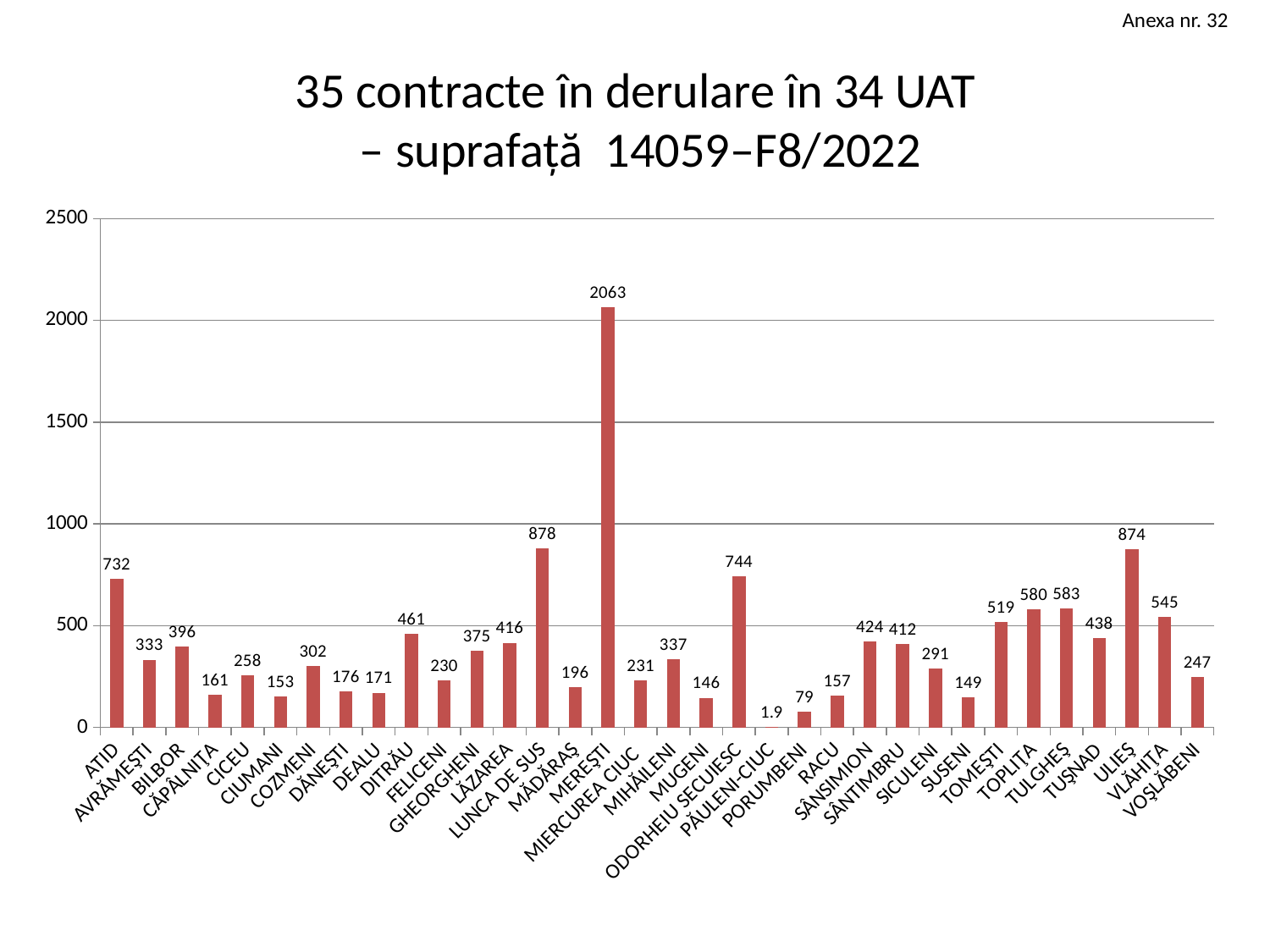
Is the value for ATID greater or less than 500? greater Which is larger, the value for DITRĂU or the value for GHEORGHENI? DITRĂU Which category has the lowest value? PĂULENI-CIUC Which category has the highest value? MEREȘTI What is the value for MEREȘTI? 2063 How many categories are shown on the x axis? 34 What is the value for ODORHEIU SECUIESC? 744 What is the value for PĂULENI-CIUC? 1.9 What kind of chart is shown on the slide? bar chart What is the difference between the values for ATID and AVRĂMEȘTI? 399 What is the value for VLĂHIȚA? 545 What is the difference between the values for MEREȘTI and LUNCA DE SUS? 1185